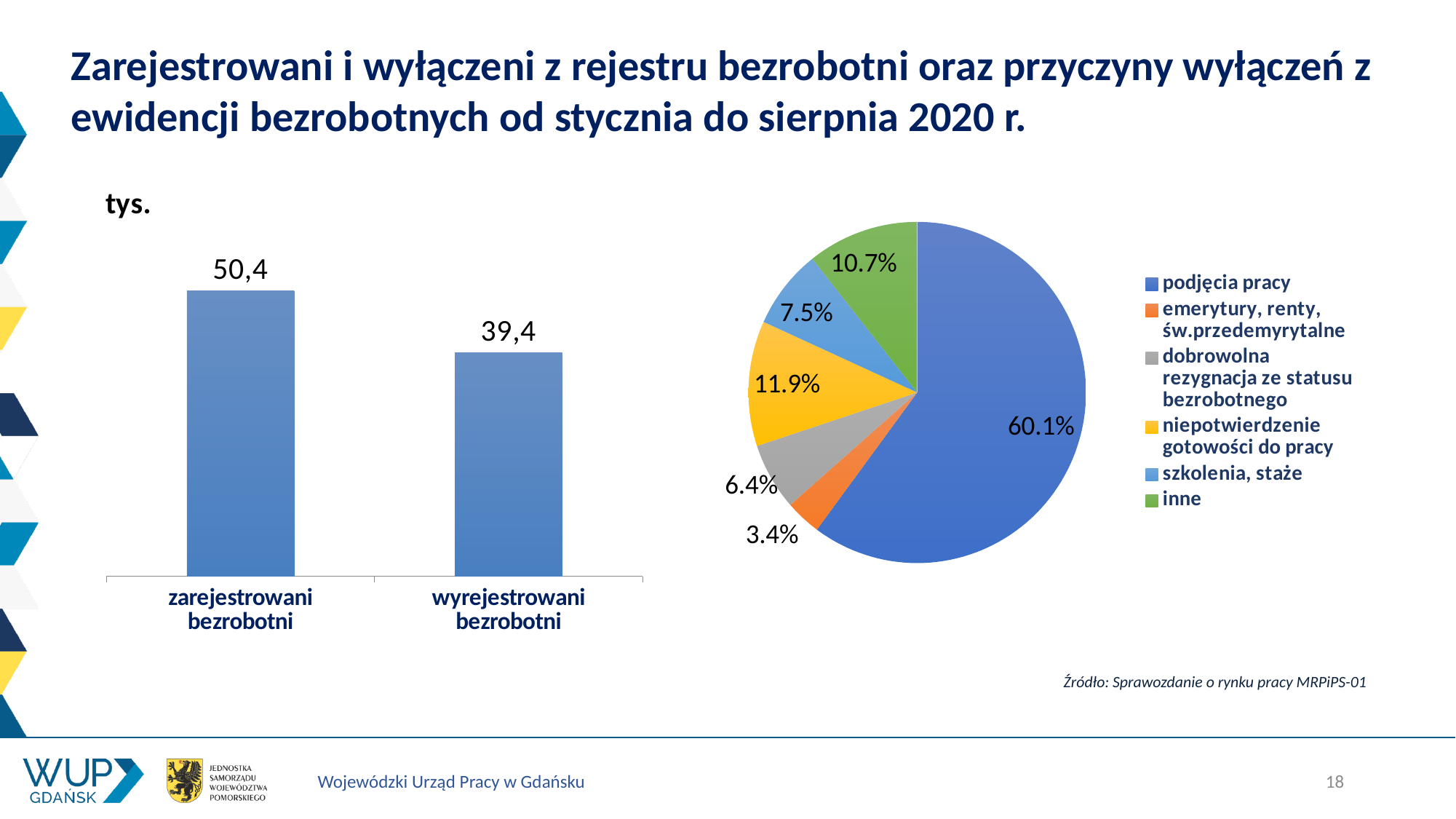
What type of chart is on the left side of the slide? bar chart In the bar chart on the left, what unit is indicated above the chart? tys. In the bar chart on the left, which category has the higher value? zarejestrowani bezrobotni In the bar chart on the left, how many bars are shown? 2 In the pie chart on the right, how many categories does the legend list? 6 In the bar chart on the left, what is the value for zarejestrowani bezrobotni? 50,4 In the pie chart on the right, which category has the smallest share? emerytury, renty, św.przedemyrytalne In the bar chart on the left, what is the difference between zarejestrowani bezrobotni and wyrejestrowani bezrobotni? 11,0 In the bar chart on the left, what is the value for wyrejestrowani bezrobotni? 39,4 In the pie chart on the right, what share does niepotwierdzenie gotowości do pracy have? 11.9% In the pie chart on the right, which is larger: szkolenia, staże or inne? inne In the pie chart on the right, what share does podjęcia pracy have? 60.1%